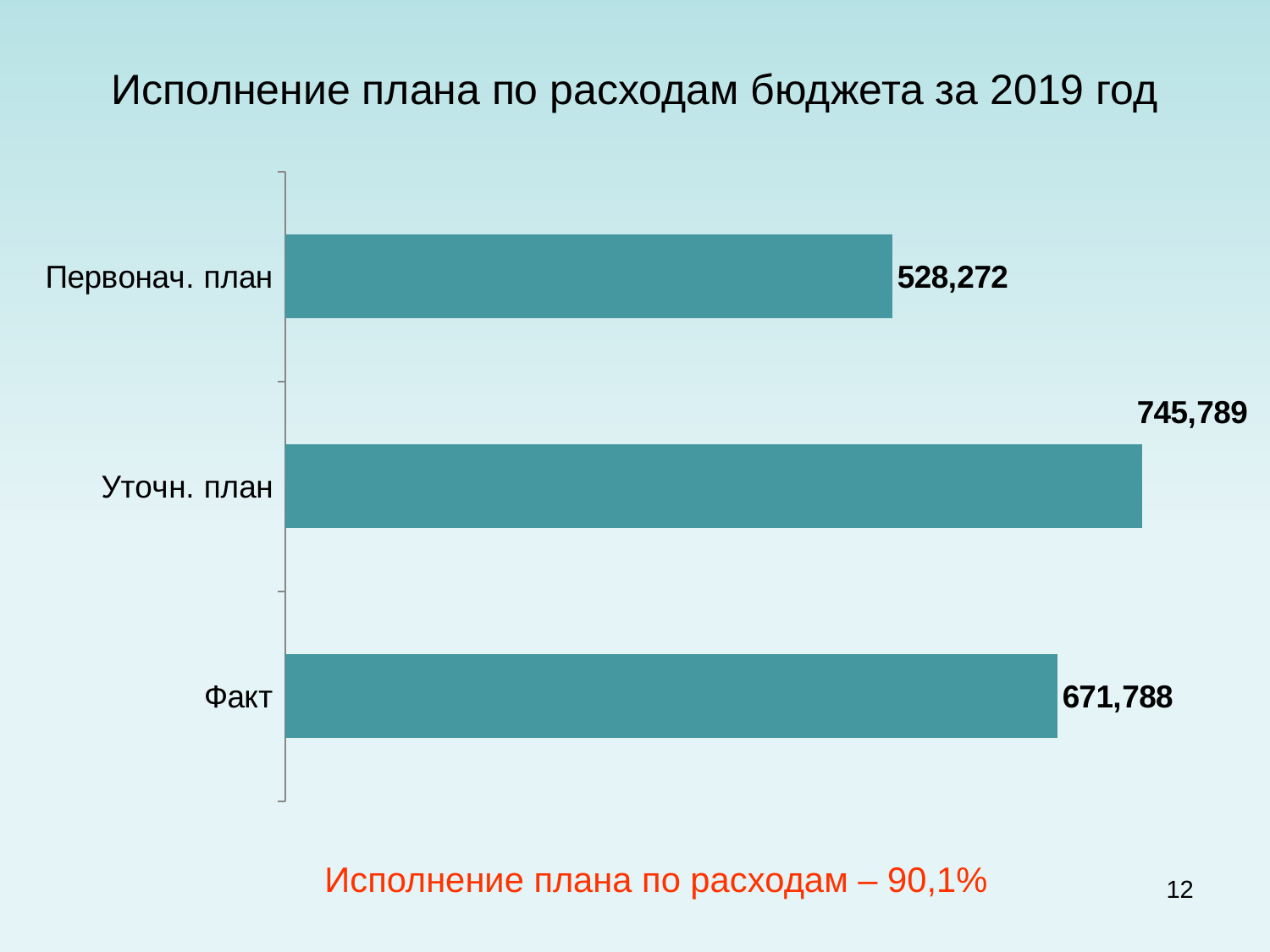
What is the value for Факт? 671,788 What is the value for Уточн. план? 745,789 What is the difference between Факт and Первонач. план? 143,516 What is the value for Первонач. план? 528,272 Which category has the highest value? Уточн. план What is the title of the slide containing the chart? Исполнение плана по расходам бюджета за 2019 год Which is larger, Факт or Первонач. план? Факт What is the difference between Уточн. план and Первонач. план? 217,517 What kind of chart is shown on the slide? Bar chart How many categories are shown in the chart? 3 What is the difference between Уточн. план and Факт? 74,001 Which category has the lowest value? Первонач. план